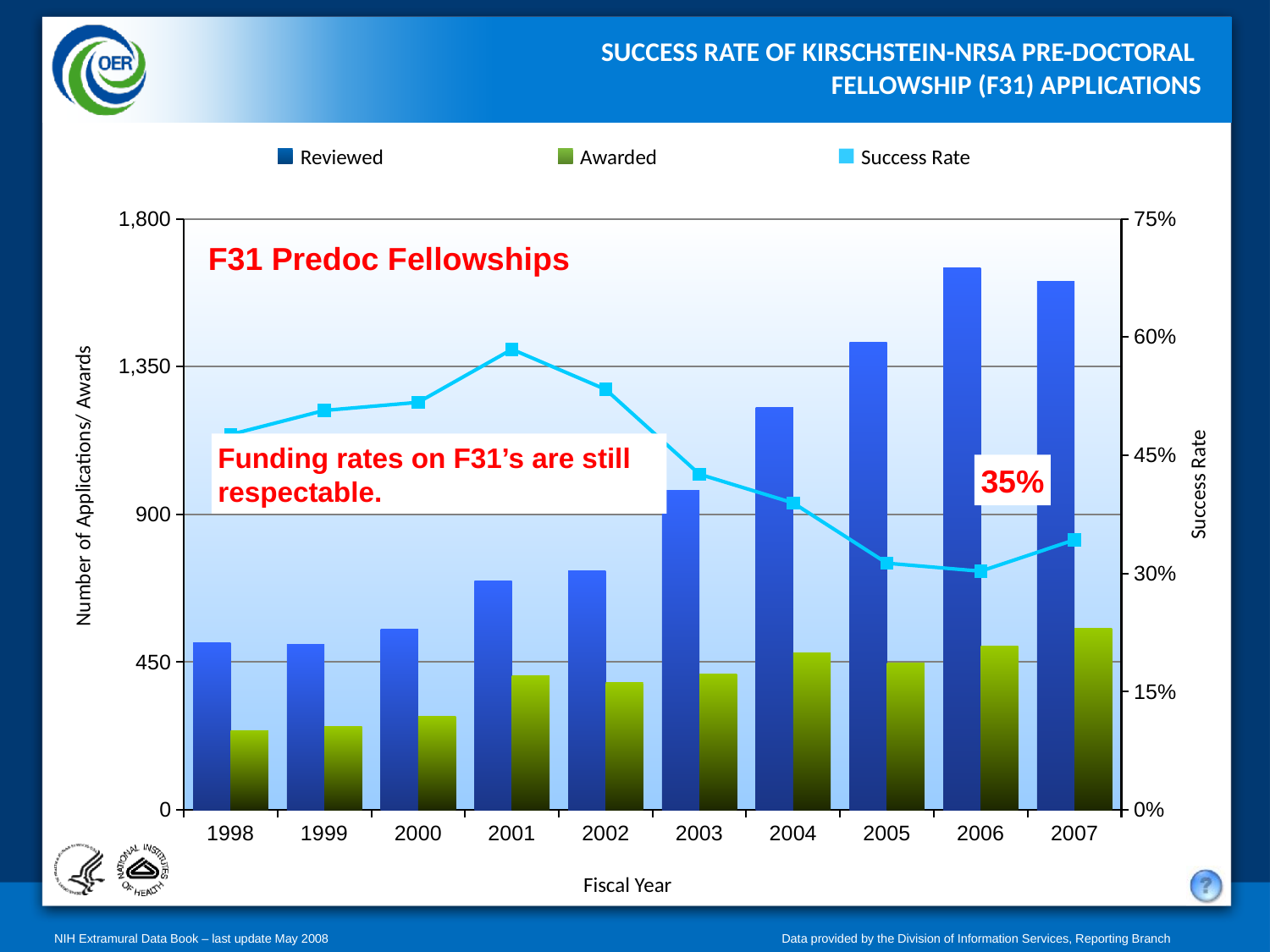
Is the number of Awarded fellowships in 2007 greater or less than 450? greater What is the title of the x axis? Fiscal Year Is the Success Rate in 2006 greater or less than 45%? less How many series does the legend list? 3 What kind of chart is shown on the slide? A bar chart combined with a line chart Is the number of Reviewed applications in 2006 greater or less than 1,350? greater In which fiscal year is the number of Awarded fellowships highest? 2007 Does the Success Rate rise or fall from 2001 to 2006? It falls How many fiscal years are shown on the x axis? 10 In which fiscal year is the number of Reviewed applications highest? 2006 In which fiscal year is the Success Rate highest? 2001 Which year had more Reviewed applications, 2003 or 2004? 2004